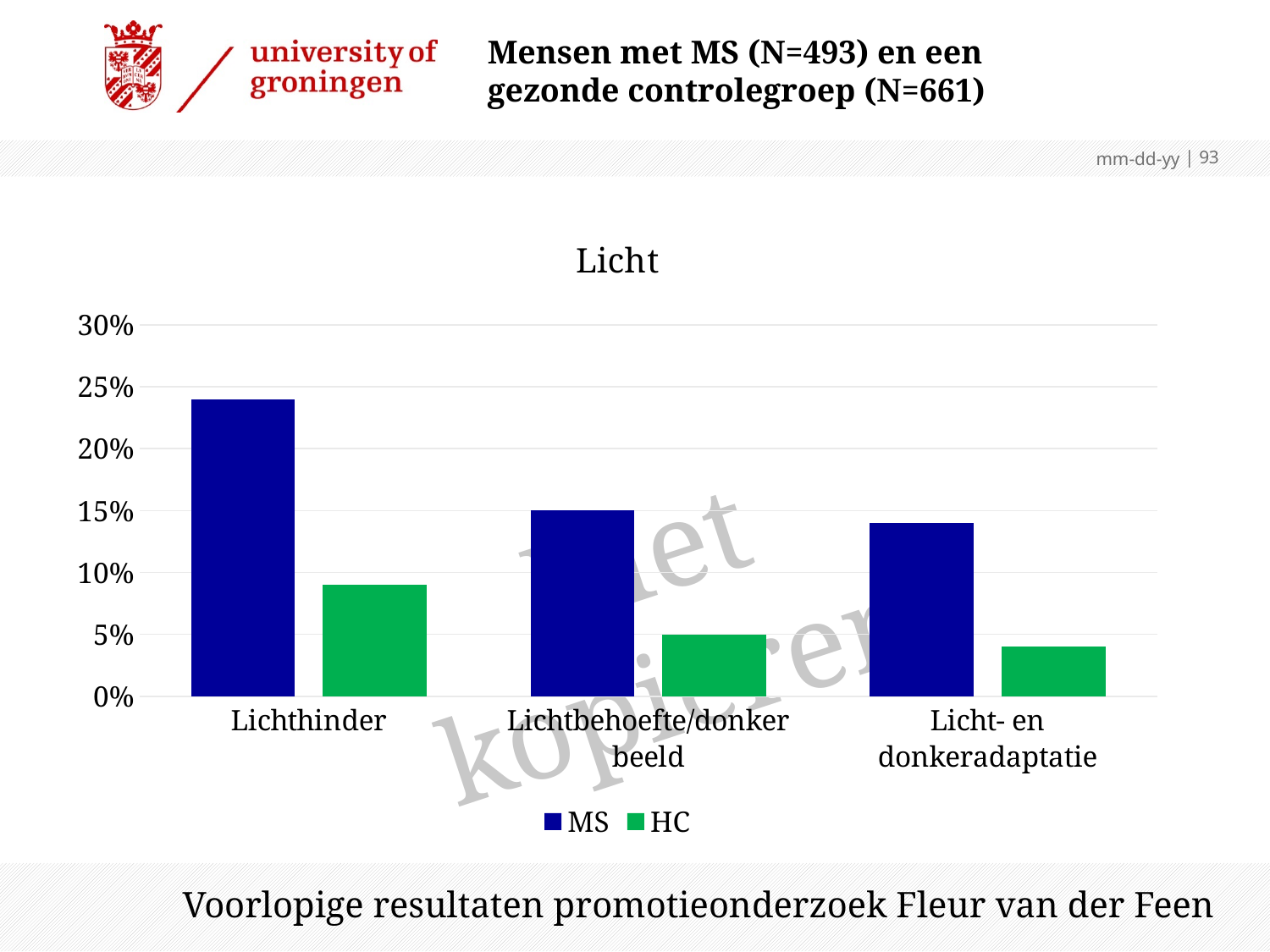
Is the MS value for Licht- en donkeradaptatie greater or less than 10%? greater What is the title of the chart? Licht Which series is shown in green in the legend? HC Is the HC value for Lichthinder greater or less than 10%? less Is the MS value for Lichthinder greater or less than 20%? greater How many categories are shown on the x axis? 3 Which category has the highest MS value? Lichthinder Which category has the lowest HC value? Licht- en donkeradaptatie For Lichtbehoefte/donker beeld, which group has the larger value, MS or HC? MS What kind of chart is shown on the slide? bar chart How many series does the legend list? 2